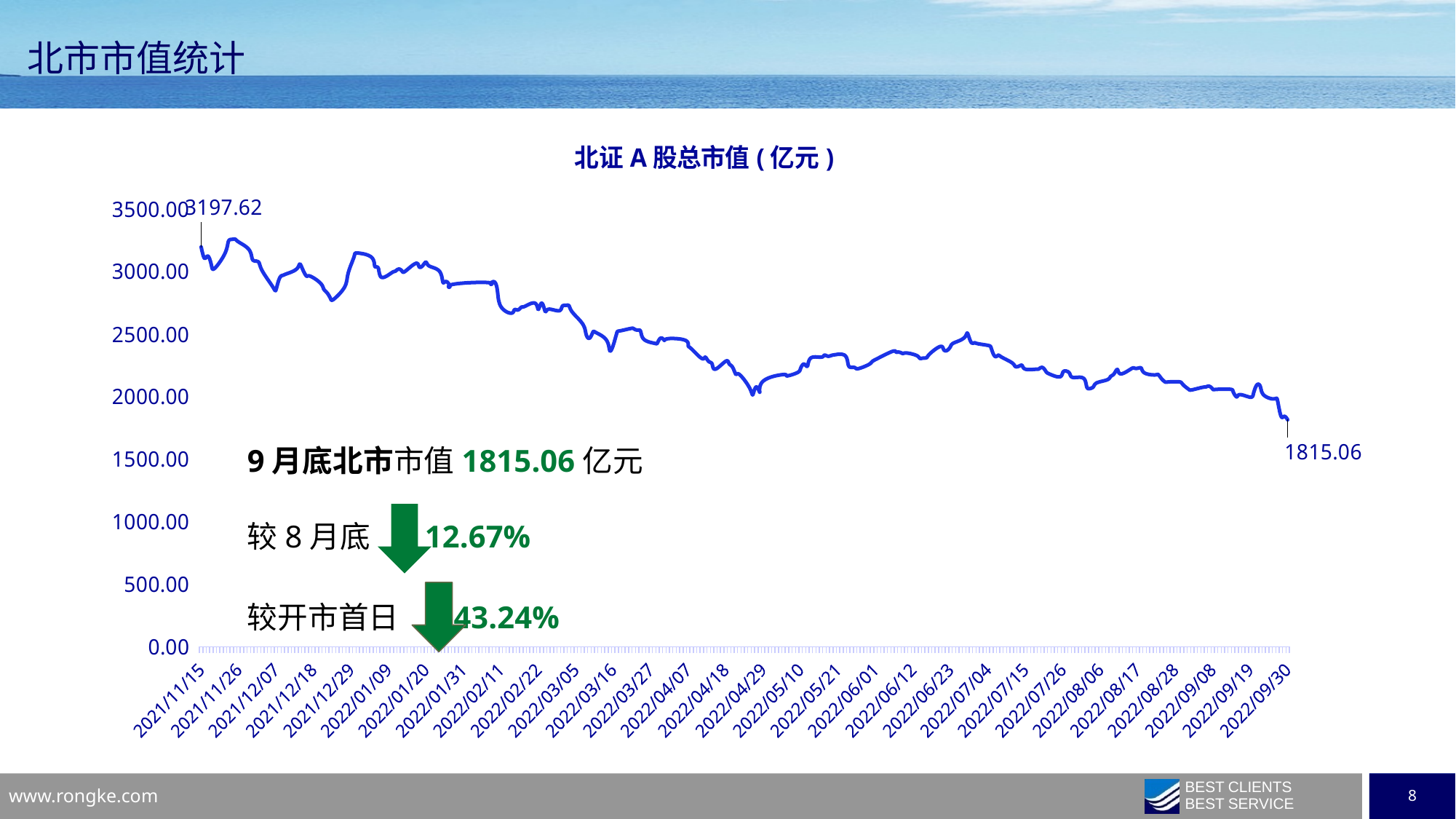
On which date does the line reach its lowest value? 2022/09/30 Do the values generally rise or fall from 2021/11/15 to 2022/09/30? fall What is the difference between the value on 2021/11/15 and the value on 2022/09/30? 1382.56 Is the value around 2022/06/23 greater or less than 2000? greater What is the title of the chart? 北证A股总市值(亿元) Which date has the larger value, 2021/11/15 or 2022/09/30? 2021/11/15 What is the value of 北证A股总市值 on 2021/11/15? 3197.62 What is the highest tick value shown on the y axis? 3500.00 Is the value around 2022/04/29 greater or less than 2500? less Is the value around 2022/01/09 greater or less than 2500? greater What is the value of 北证A股总市值 on 2022/09/30? 1815.06 What kind of chart is shown on the slide? line chart